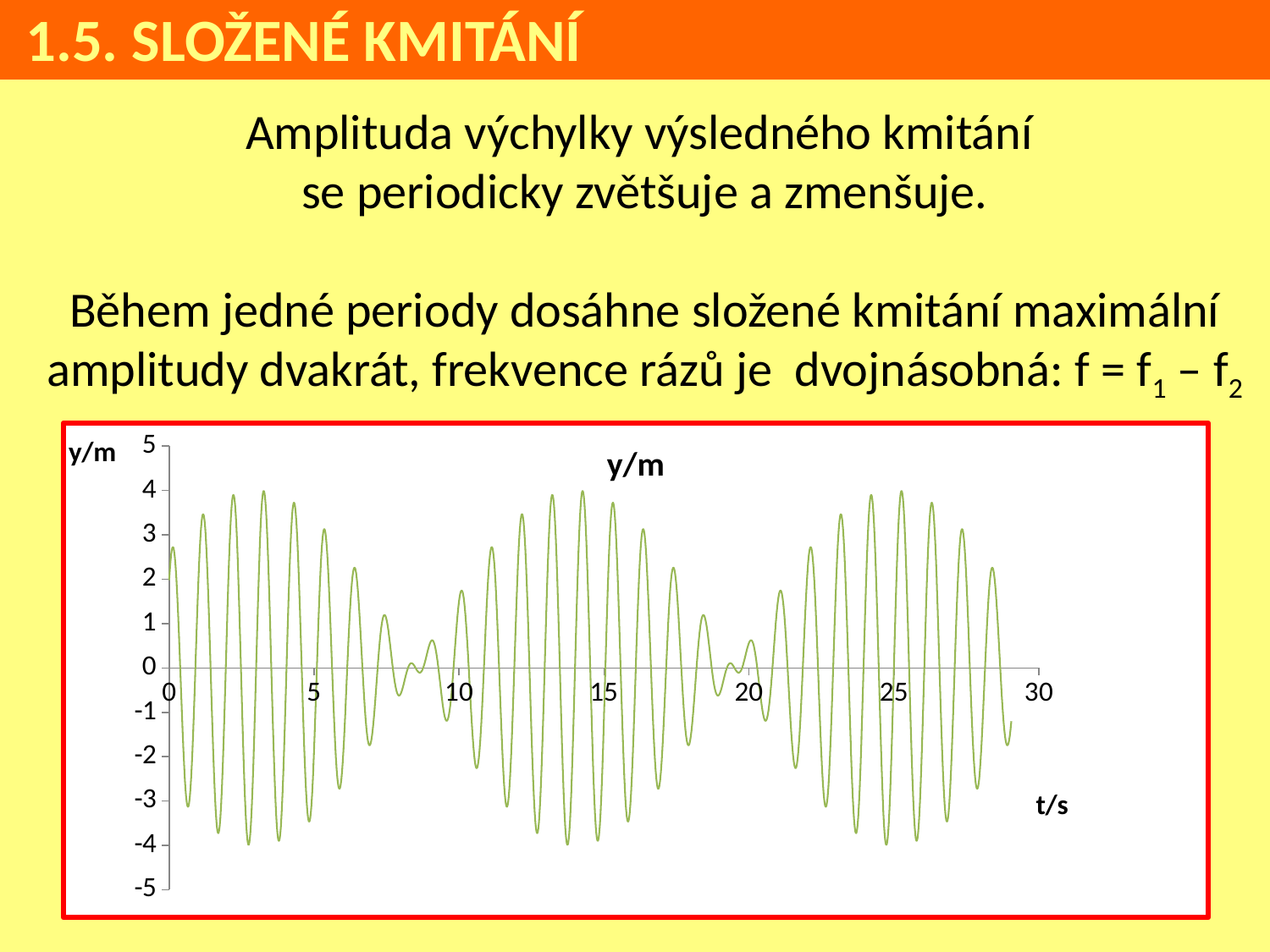
What is the title of the chart? y/m What is the largest tick value shown on the vertical axis? 5 Does the amplitude of the oscillation stay constant or vary periodically along the t axis? varies periodically How many times does the envelope of the oscillation reach its maximum amplitude within the plotted range? 3 Is the highest value reached by the curve greater or less than 3? greater What label is shown on the horizontal axis of the chart? t/s What is the largest tick value shown on the horizontal axis? 30 Is the lowest value reached by the curve greater or less than -3? less Is the highest value reached by the curve greater or less than 5? less What kind of chart is shown on the slide? line chart How many data series are plotted in the chart? 1